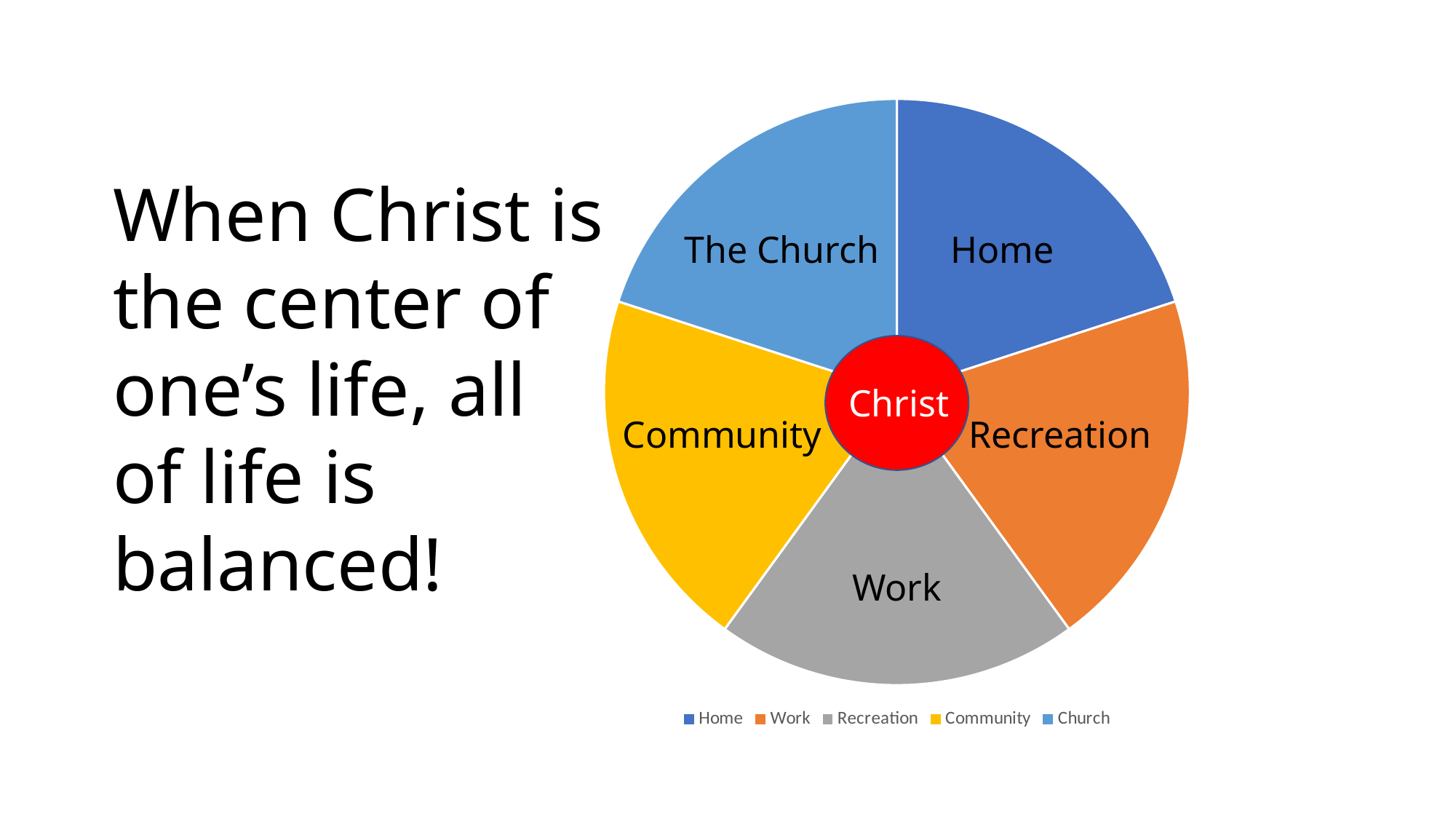
How many entries does the legend of the pie chart list? 5 What are the entries listed in the pie chart's legend, in order? Home, Work, Recreation, Community, Church How many slices does the pie chart have? 5 What word is written in the red circle at the center of the pie chart? Christ What kind of chart is shown on the slide? pie chart Are the five slices of the pie chart roughly equal in size? yes